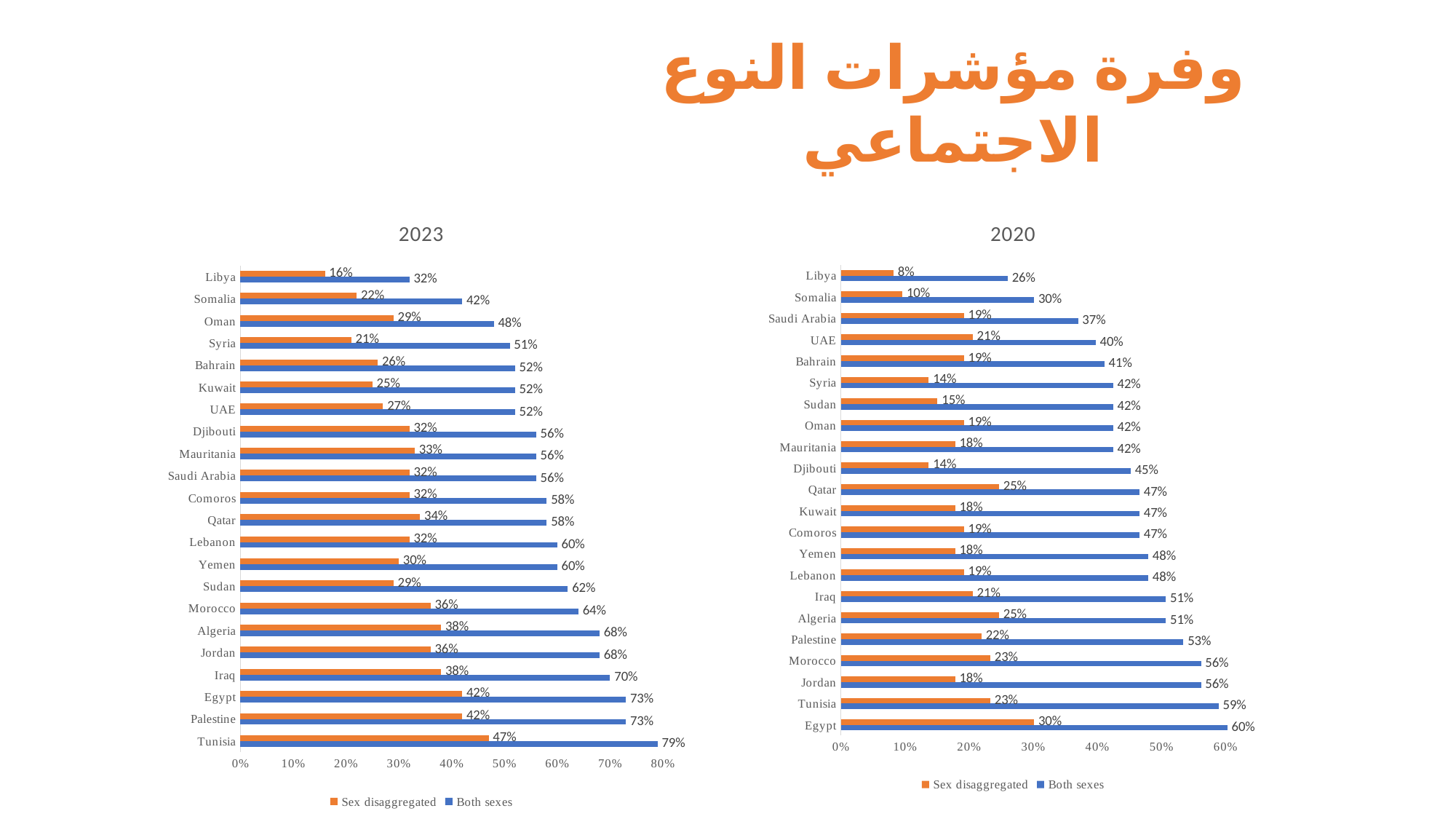
In the 2023 chart, which colour represents the Sex disaggregated series? Orange How many series does the legend of the 2023 chart list? 2 In the 2023 chart, what is the Sex disaggregated value for Libya? 16% In the 2020 chart, which is larger for Morocco: the Both sexes value or the Sex disaggregated value? Both sexes What type of chart is the 2023 chart? Bar chart In the 2023 chart, what is the difference between the Both sexes and Sex disaggregated values for Iraq? 32% How many countries are shown in the 2020 chart? 22 In the 2020 chart, what is the Both sexes value for Egypt? 60% In the 2020 chart, which country has the lowest Sex disaggregated value? Libya In the 2023 chart, what is the Both sexes value for Tunisia? 79% In the 2020 chart, what is the Sex disaggregated value for Qatar? 25% In the 2023 chart, which country has the highest Both sexes value? Tunisia